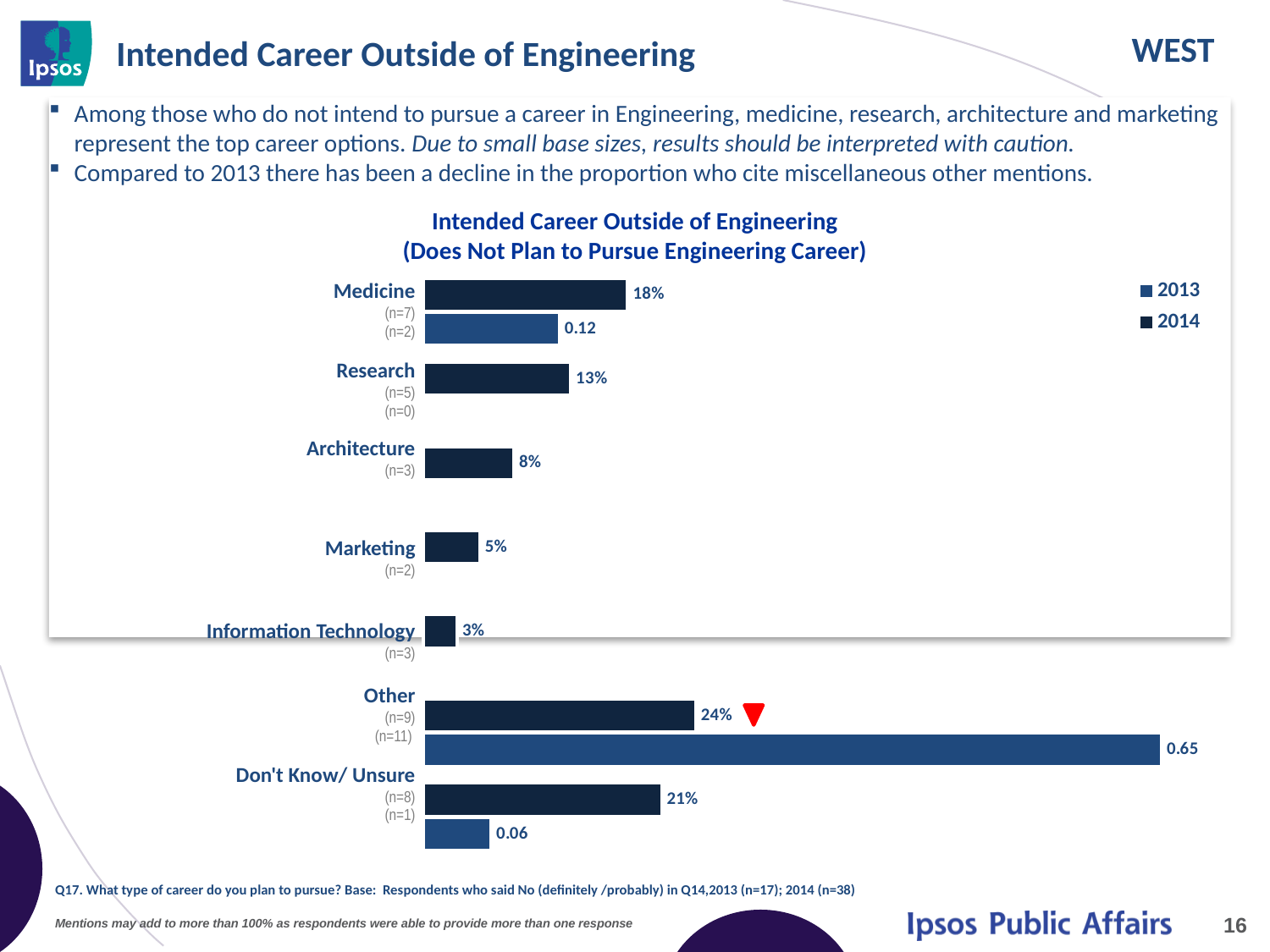
What are the two entries in the chart legend? 2013 and 2014 What is the 2013 value for Don't Know/ Unsure? 0.06 What is the 2014 value for Other? 24% What is the difference between the 2013 values for Other and Don't Know/ Unsure? 0.59 What is the 2014 value for Don't Know/ Unsure? 21% What is the 2013 value for Medicine? 0.12 Which category has the lowest 2013 value? Don't Know/ Unsure How many career categories are shown on the chart? 7 How many series does the legend list? 2 Which category has the highest 2013 value? Other What kind of chart is shown on the slide? Bar chart